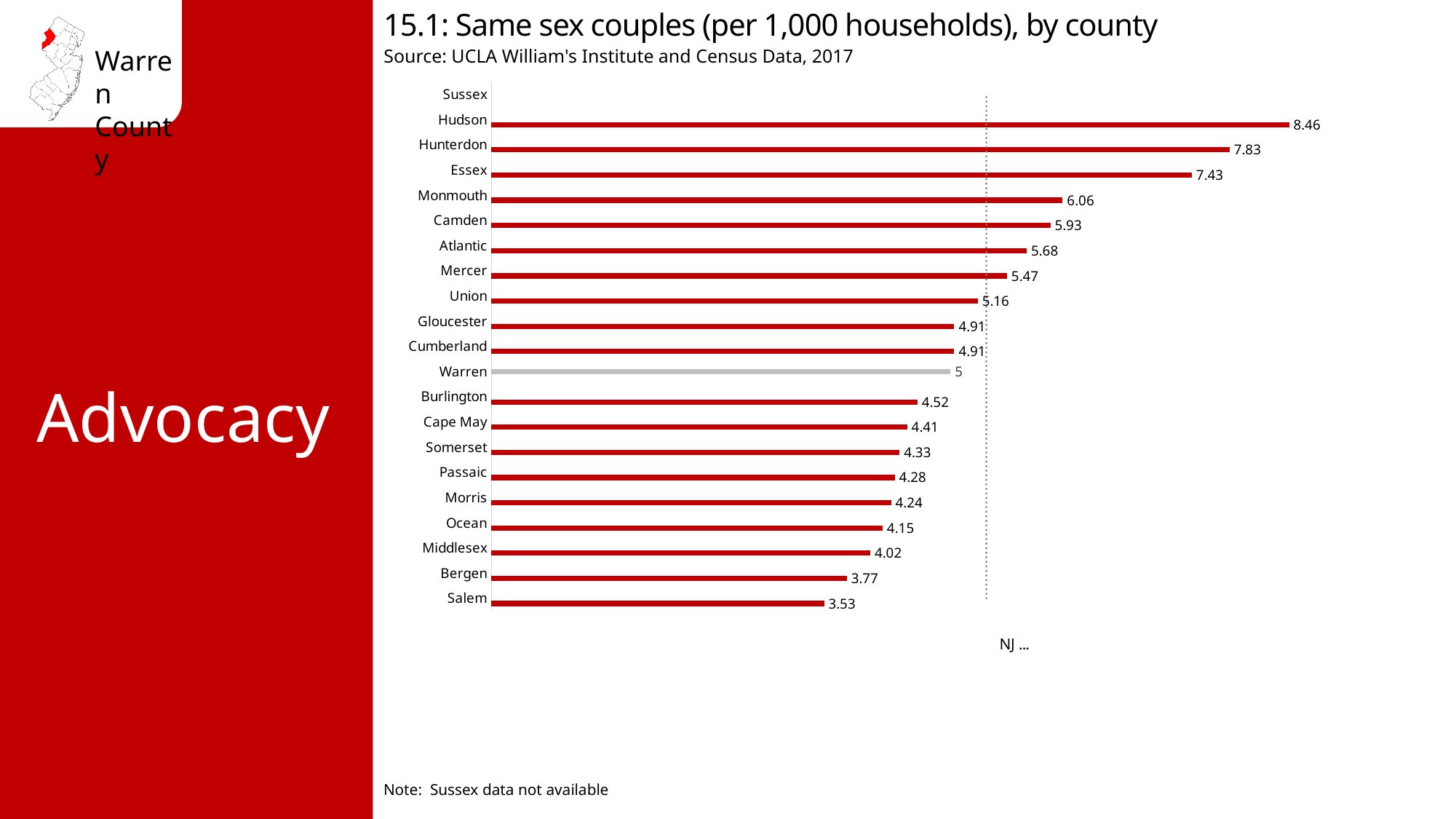
What is the value for Hudson? 8.46 What is the difference between the values for Hudson and Hunterdon? 0.63 Do the bar values increase or decrease going from the top of the chart to the bottom? Decrease What is the value for Warren? 5 What is the value for Salem? 3.53 According to the note, which county's data is not available? Sussex Which county's bar is shown in gray instead of red? Warren Which is larger, the value for Essex or the value for Monmouth? Essex How many county labels are listed on the chart's axis? 21 Which county has the highest value? Hudson Which county with a plotted bar has the lowest value? Salem What kind of chart is shown? Bar chart